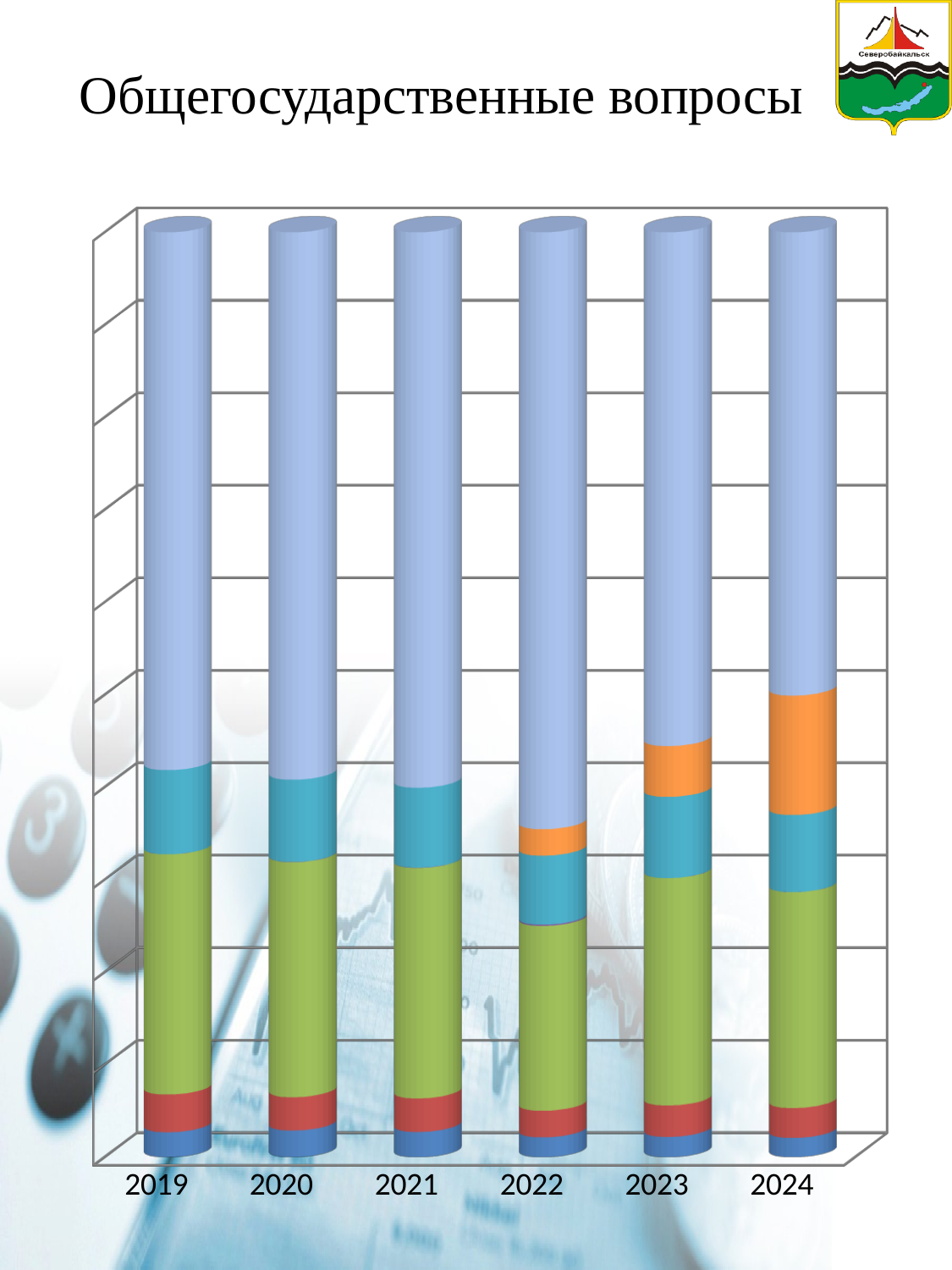
Does the orange segment grow or shrink from 2022 to 2024? grow Which segment is at the bottom of each stacked bar? the dark blue segment How many years are shown on the x axis of the chart? 6 What kind of chart is shown on the slide? stacked bar chart What is the first year shown on the x axis? 2019 What is the title of the slide? Общегосударственные вопросы In which year does the orange segment first appear in the stacked bars? 2022 Is the orange segment larger in 2023 or in 2024? 2024 Which year has the smallest orange segment? 2022 What is the last year shown on the x axis? 2024 Which year has the largest orange segment? 2024